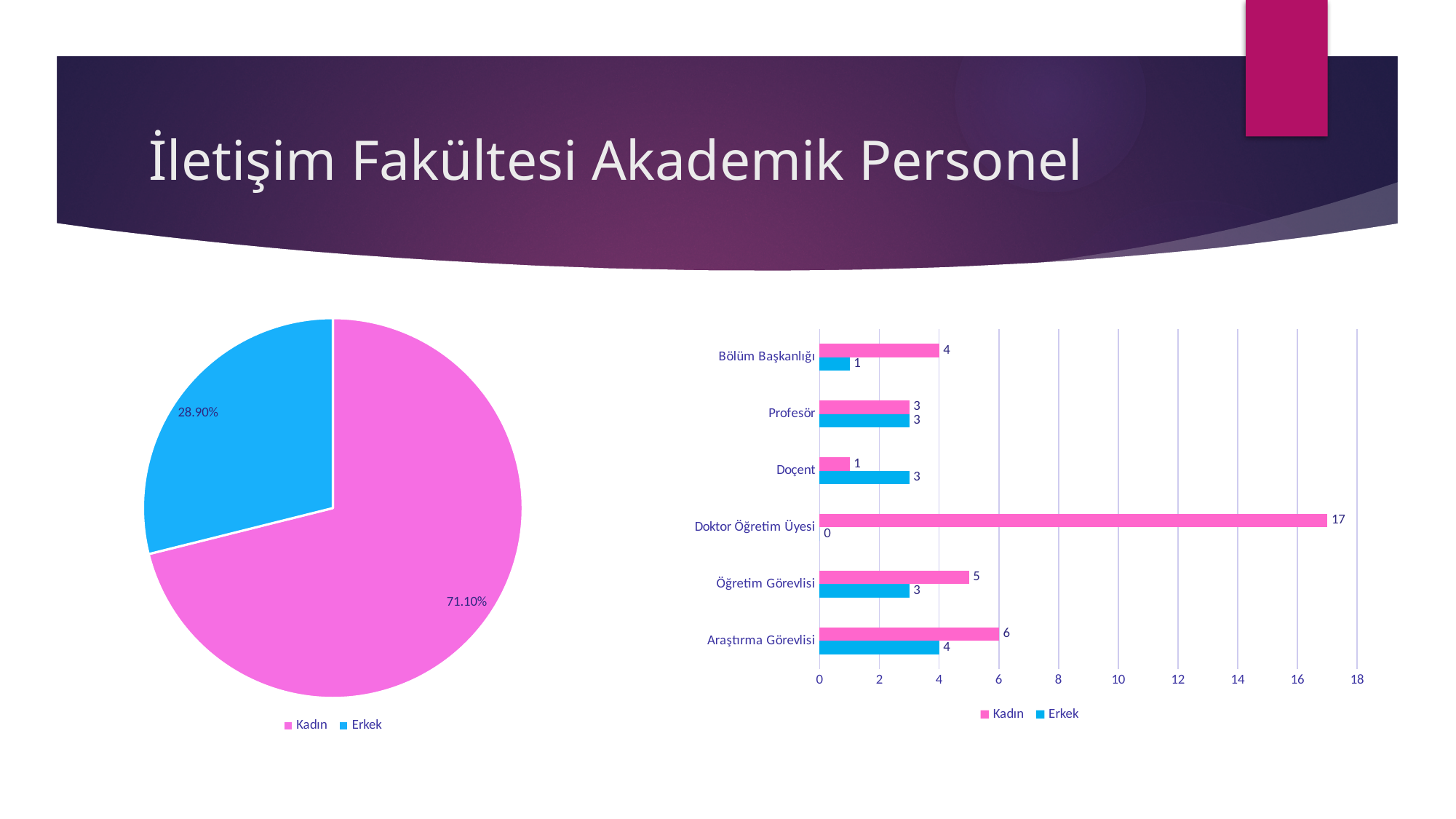
In the bar chart on the right, which is larger for Doçent, the Kadın value or the Erkek value? Erkek In the pie chart on the left, what share does Kadın have? 71.10% In the pie chart on the left, what share does Erkek have? 28.90% How many series does the legend of the bar chart on the right list? 2 In the bar chart on the right, what is the Erkek value for Araştırma Görevlisi? 4 In the bar chart on the right, which category has the lowest Erkek value? Doktor Öğretim Üyesi How many categories are shown in the bar chart on the right? 6 In the bar chart on the right, what is the Kadın value for Doktor Öğretim Üyesi? 17 In the bar chart on the right, which category has the highest Kadın value? Doktor Öğretim Üyesi What kind of chart is the chart on the left? pie chart What kind of chart is the chart on the right? bar chart In the bar chart on the right, what is the difference between the Kadın and Erkek values for Bölüm Başkanlığı? 3